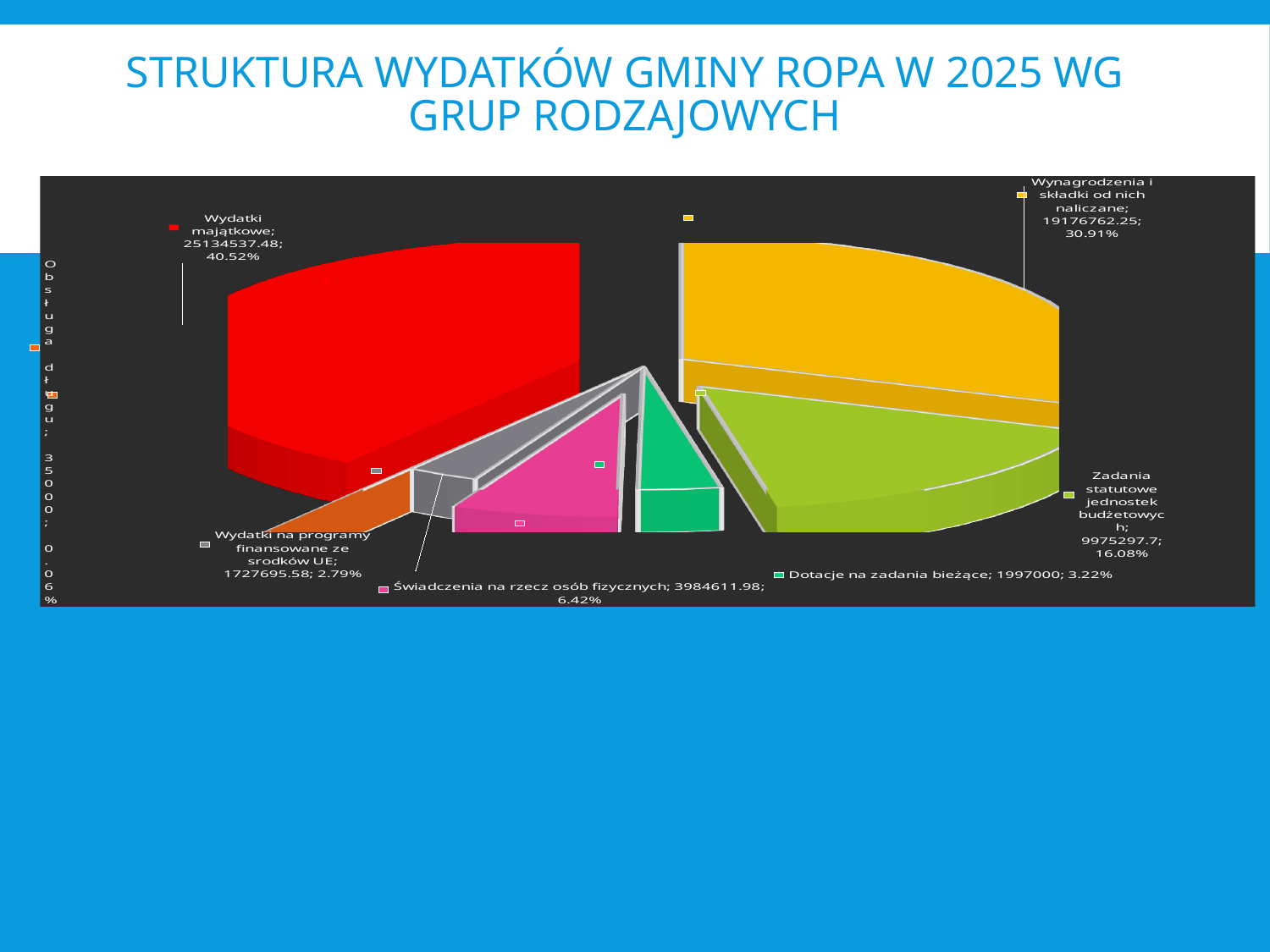
What is the value shown for Wydatki majątkowe? 25134537.48 Which category has the largest share of the pie? Wydatki majątkowe What is the title of the chart on the slide? STRUKTURA WYDATKÓW GMINY ROPA W 2025 WG GRUP RODZAJOWYCH Which category has the smallest share of the pie? Obsługa długu What is the difference in percentage share between Wydatki majątkowe and Wynagrodzenia i składki od nich naliczane? 9.61% How many categories (slices) does the pie chart show? 7 What is the value shown for Zadania statutowe jednostek budżetowych? 9975297.7 What kind of chart is shown on the slide? Pie chart What percentage share does Dotacje na zadania bieżące have? 3.22% What is the value shown for Świadczenia na rzecz osób fizycznych? 3984611.98 What percentage share does Wynagrodzenia i składki od nich naliczane have? 30.91% Which is larger: Świadczenia na rzecz osób fizycznych or Dotacje na zadania bieżące? Świadczenia na rzecz osób fizycznych